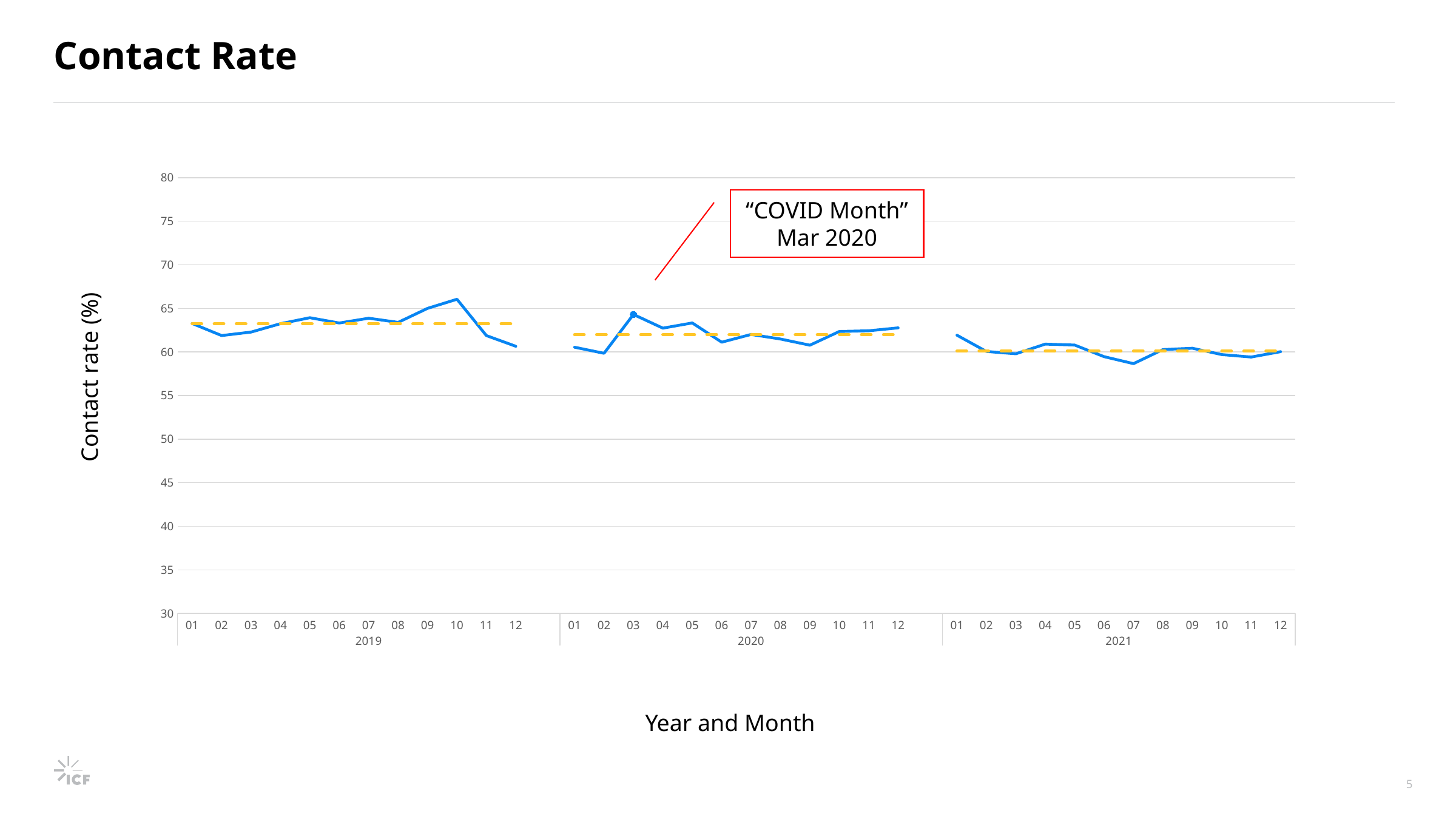
What is the title of the chart on the slide? Contact Rate Do the contact rate values generally rise or fall from 2019 to 2021? fall How many monthly data points are plotted across the chart? 36 Which month has the highest contact rate on the chart? 10 (2019) Is the contact rate for month 12 of 2019 greater or less than 65? less Is the contact rate for month 03 of 2020 greater or less than 60? greater Is the contact rate for month 10 of 2019 greater or less than 65? greater What kind of chart is shown on the slide? line chart Is the contact rate for month 10 of 2019 higher or lower than for month 07 of 2021? higher What label is shown on the vertical axis of the chart? Contact rate (%) How many years are shown along the x axis of the chart? 3